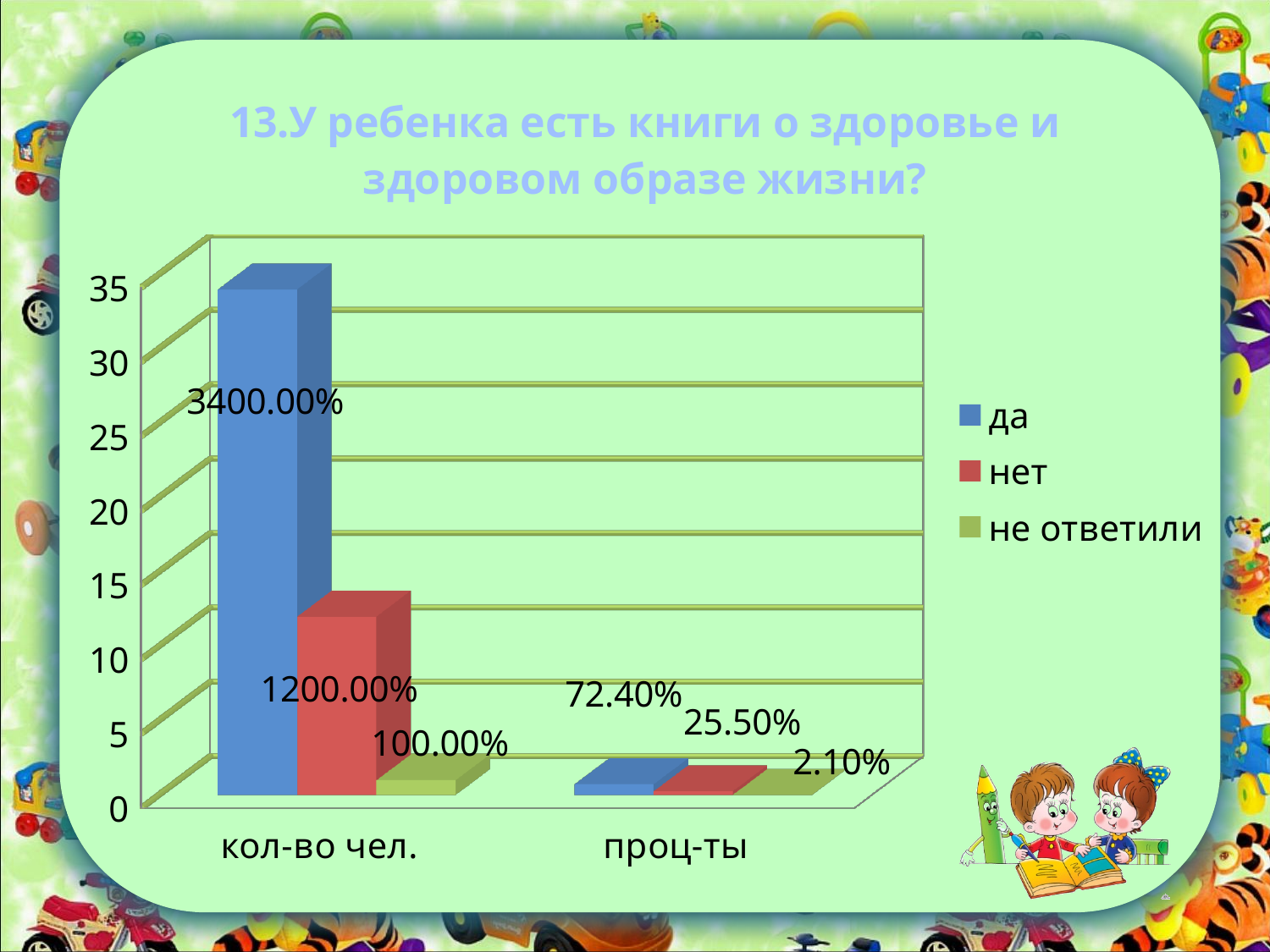
What is the data label for the 'да' bar in the 'проц-ты' category? 72.40% Which series has the smallest value in the 'проц-ты' category? не ответили What is the data label for the 'не ответили' bar in the 'кол-во чел.' category? 100.00% How many categories are shown on the x axis? 2 How many series does the legend list? 3 What is the data label for the 'да' bar in the 'кол-во чел.' category? 3400.00% What kind of chart is shown on the slide? bar chart Which series has the tallest bar in the 'кол-во чел.' category? да What is the data label for the 'не ответили' bar in the 'проц-ты' category? 2.10% What is the data label for the 'нет' bar in the 'проц-ты' category? 25.50% What is the data label for the 'нет' bar in the 'кол-во чел.' category? 1200.00% What is the difference between the 'да' and 'нет' data labels in the 'проц-ты' category? 46.90%